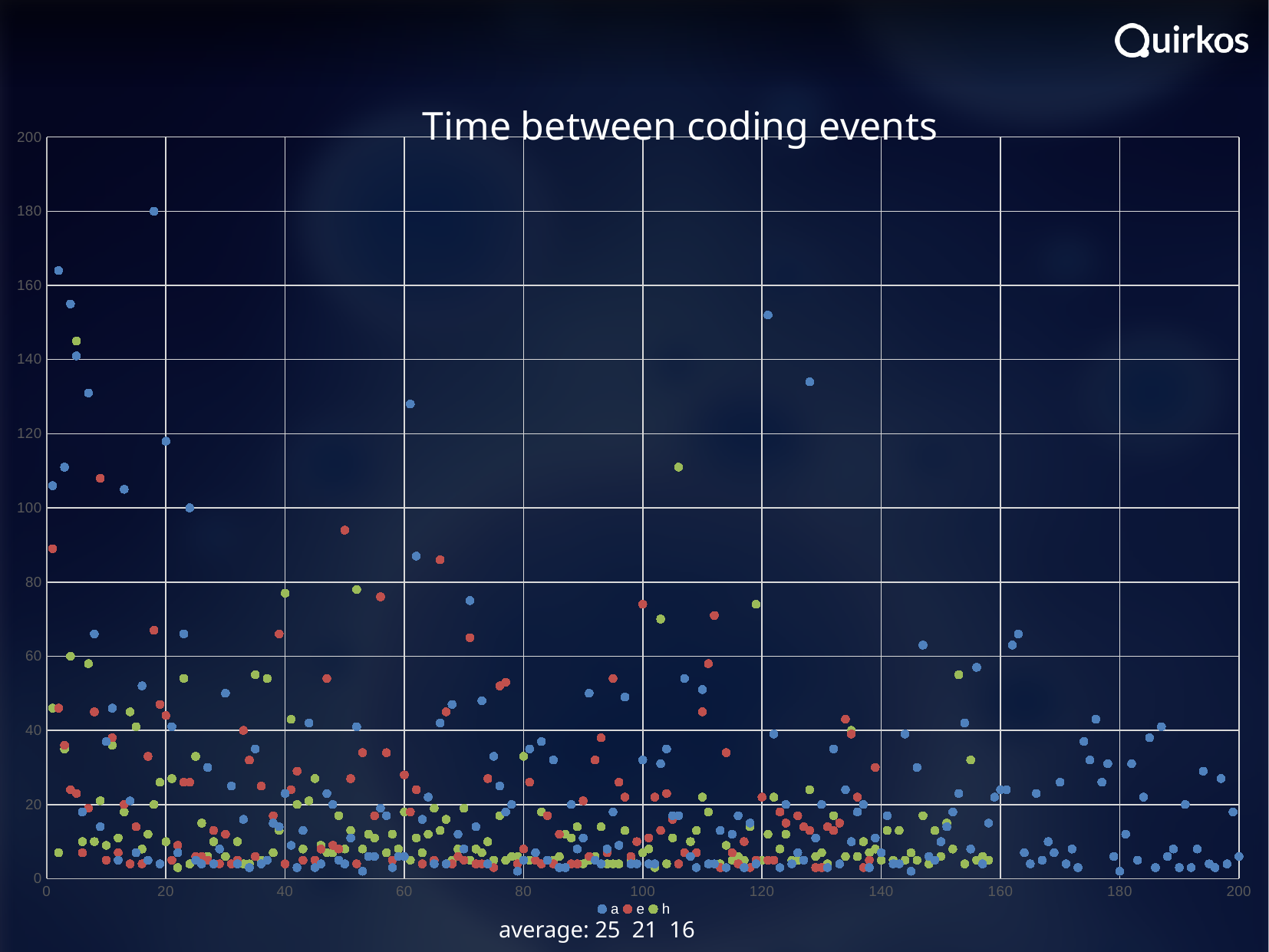
Is the average for series e greater or less than the average for series h? greater What kind of chart is shown on the slide? scatter plot Which series has the lowest average? h What are the names of the series in the legend? a, e, h Is the highest plotted point on the chart greater or less than 160? greater What is the average shown for series e? 21 What is the average shown for series h? 16 Which series has the highest average? a What is the title of the chart? Time between coding events What is the difference between the averages of series a and series h? 9 How many series does the legend list? 3 What is the average shown for series a? 25